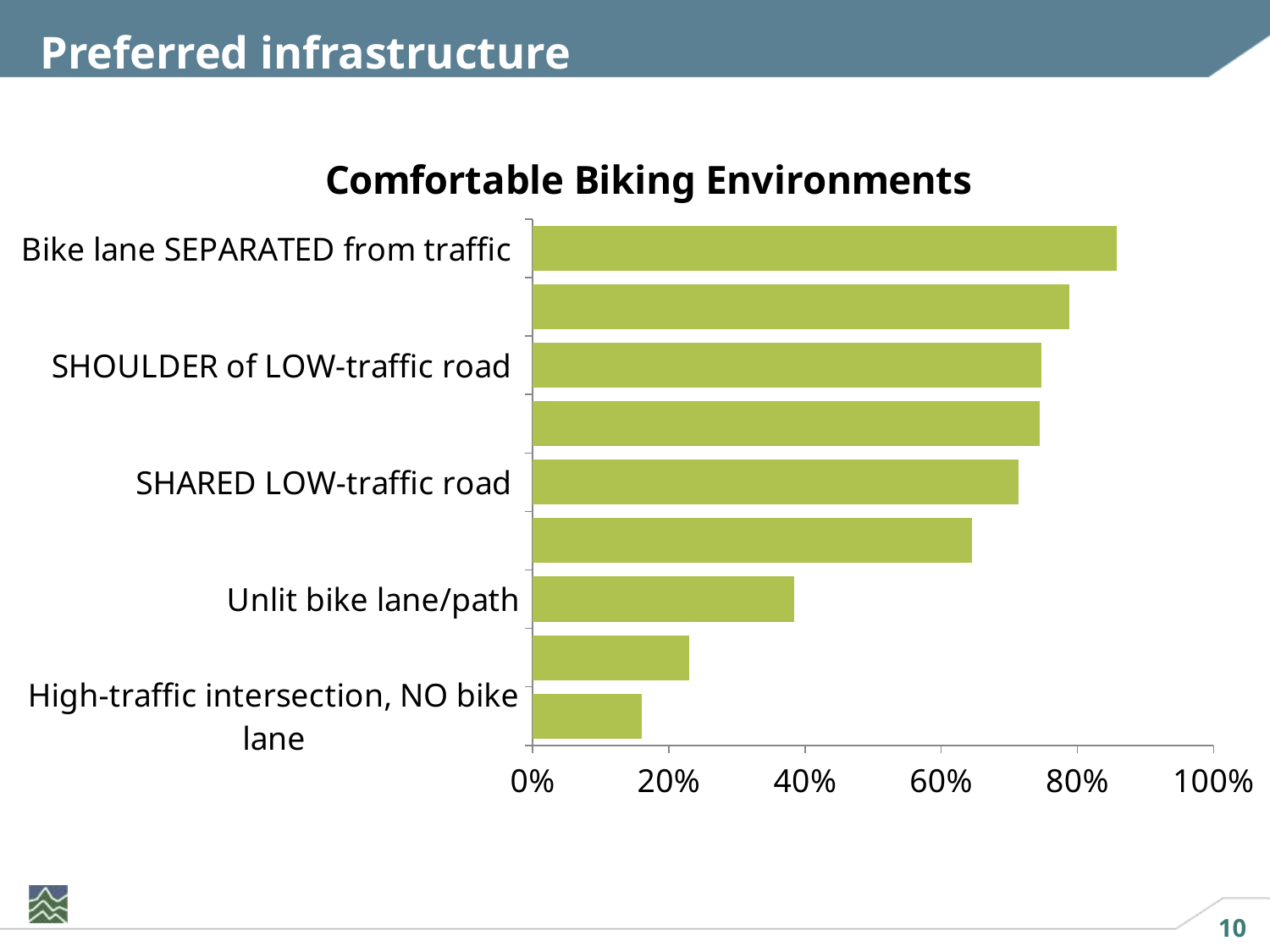
What is the title of the chart? Comfortable Biking Environments Which is larger, the value for Unlit bike lane/path or the value for High-traffic intersection, NO bike lane? Unlit bike lane/path Which is larger, the value for Bike lane SEPARATED from traffic or the value for Unlit bike lane/path? Bike lane SEPARATED from traffic Is the value for Bike lane SEPARATED from traffic greater or less than 80%? greater Is the value for High-traffic intersection, NO bike lane greater or less than 20%? less What kind of chart is shown on the slide? bar chart Which labeled category has the lowest value? High-traffic intersection, NO bike lane Is the value for Unlit bike lane/path greater or less than 40%? less Do the bar values rise or fall going from the top of the chart to the bottom? fall Which labeled category has the highest value? Bike lane SEPARATED from traffic How many bars are plotted in the chart? 9